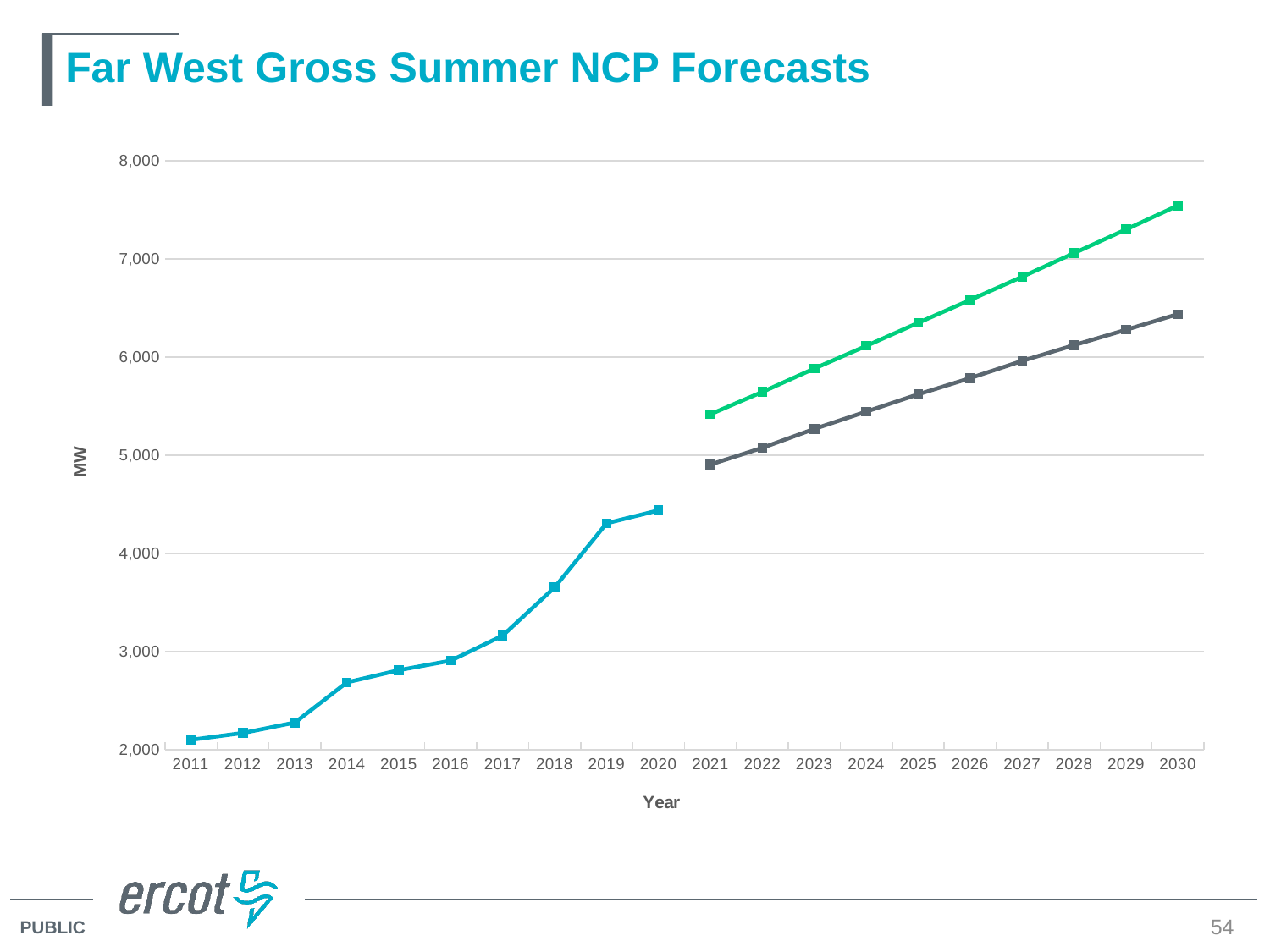
Is the value of the green line for 2030 greater or less than 7,000? greater How many separate lines are plotted on the chart? 3 What kind of chart is shown on the slide? Line chart What is the label on the vertical axis? MW How many years are shown on the x axis? 20 Is the value of the green line for 2021 greater or less than 5,000? greater What is the title of the chart? Far West Gross Summer NCP Forecasts Is the value of the dark grey line for 2030 greater or less than 6,000? greater In 2030, which line has the higher value, the green line or the dark grey line? Green line Does the blue line rise or fall from 2011 to 2020? Rise